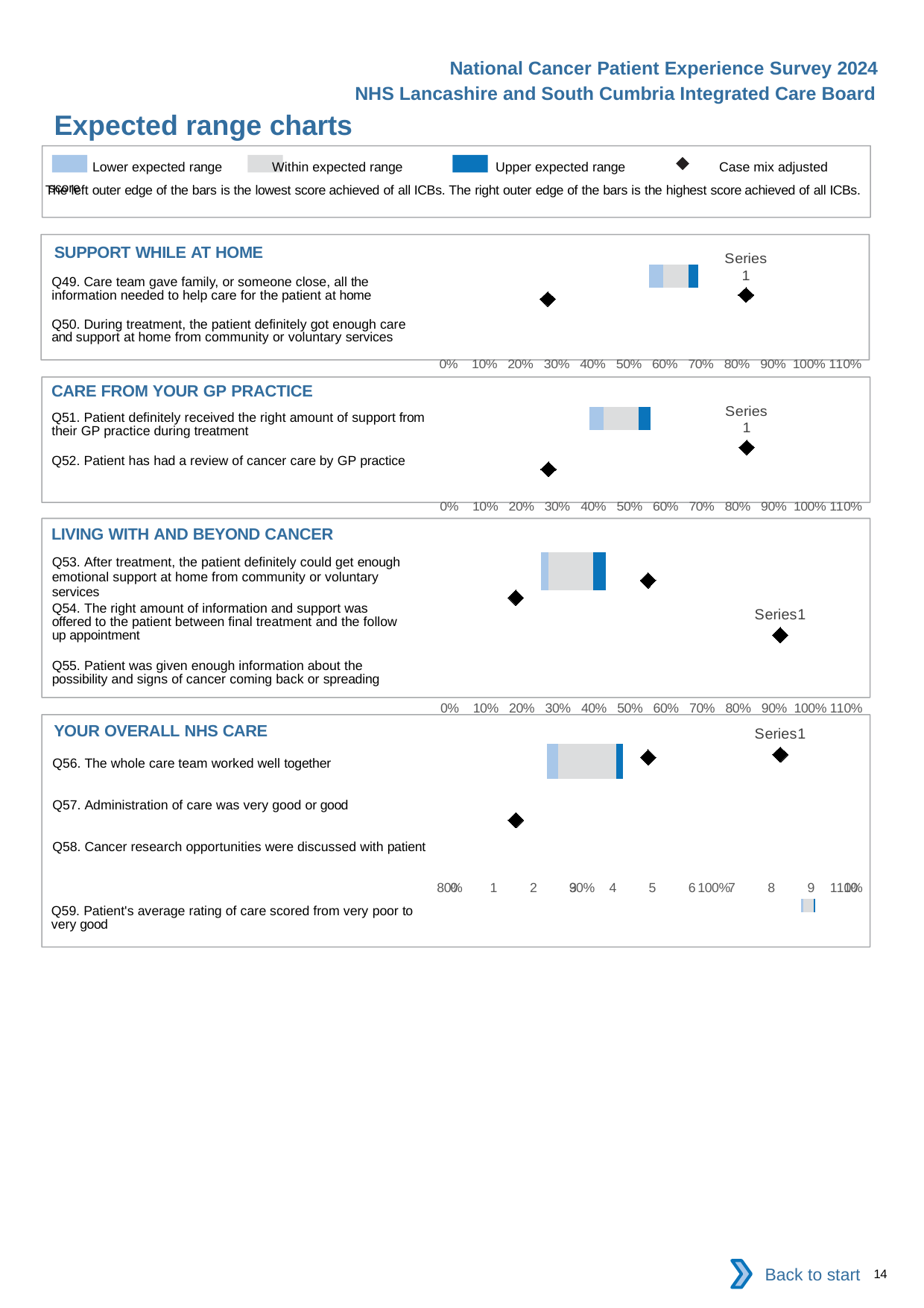
In the CARE FROM YOUR GP PRACTICE chart, is the rightmost diamond marker greater or less than 70%? greater What kind of chart is used in the expected range charts on this slide? bar chart How many diamond markers are plotted in the LIVING WITH AND BEYOND CANCER chart? 3 How many entries does the legend at the top of the slide list? 4 How many section charts (SUPPORT WHILE AT HOME, CARE FROM YOUR GP PRACTICE, LIVING WITH AND BEYOND CANCER, YOUR OVERALL NHS CARE) are shown on the slide? 4 In the YOUR OVERALL NHS CARE chart, is the leftmost diamond marker greater or less than 30%? less What is the highest tick label on the x axis of the SUPPORT WHILE AT HOME chart? 110% In the CARE FROM YOUR GP PRACTICE chart, is the leftmost diamond marker greater or less than 50%? less How many diamond markers are plotted in the SUPPORT WHILE AT HOME chart? 2 According to the legend, what does the diamond marker represent? Case mix adjusted score